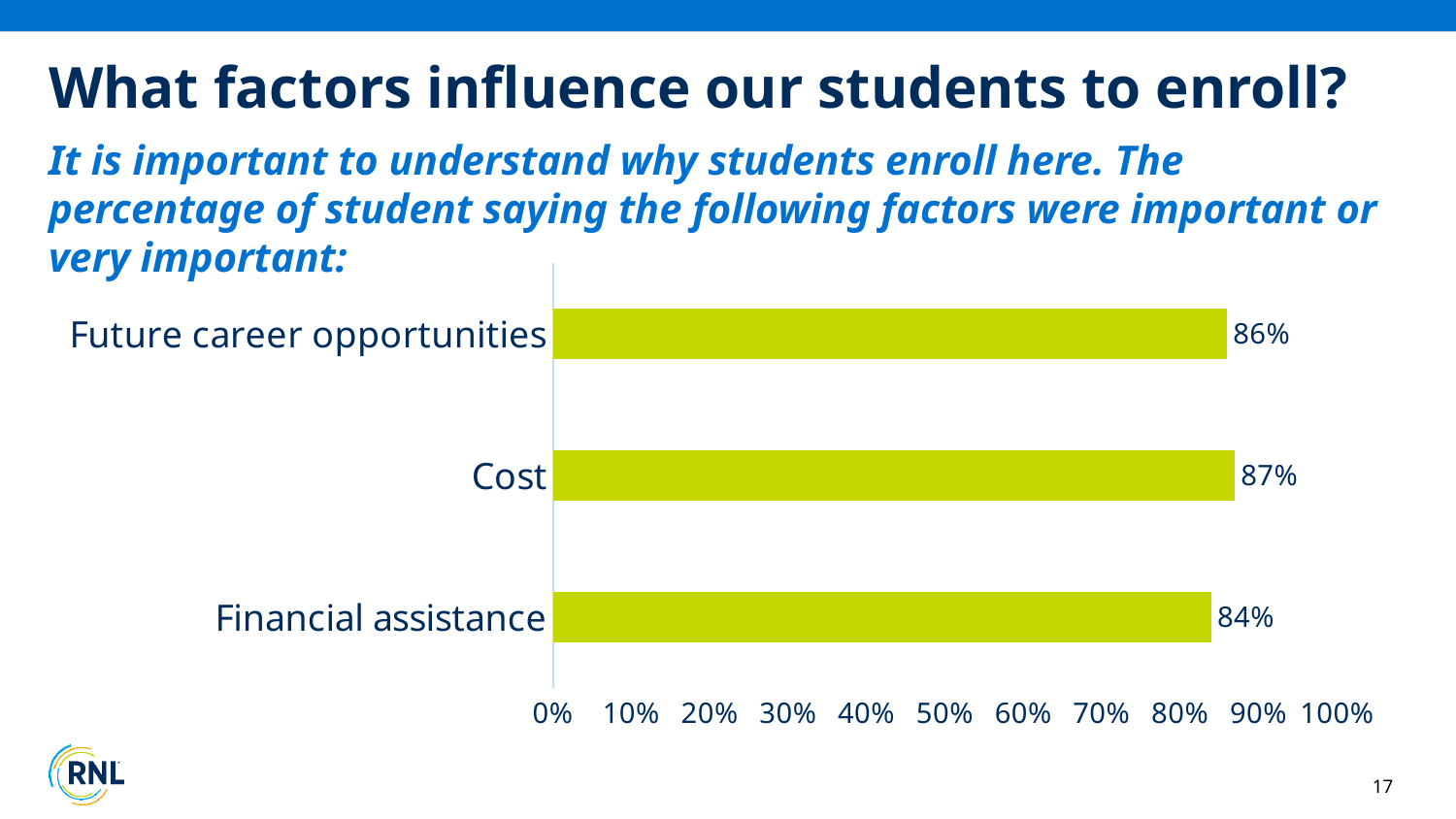
How many factors are shown in the chart? 3 What is the difference between the values for Future career opportunities and Financial assistance? 2% What is the maximum value shown on the x axis? 100% Is the value for Financial assistance greater or less than 80%? greater What kind of chart is shown on the slide? Bar chart Which factor has the highest percentage? Cost What is the value shown for Cost? 87% What is the difference between the values for Cost and Financial assistance? 3% Which factor has the lowest percentage? Financial assistance Which is larger, the value for Cost or the value for Future career opportunities? Cost What is the value shown for Financial assistance? 84% What percentage of students said Future career opportunities was important or very important? 86%